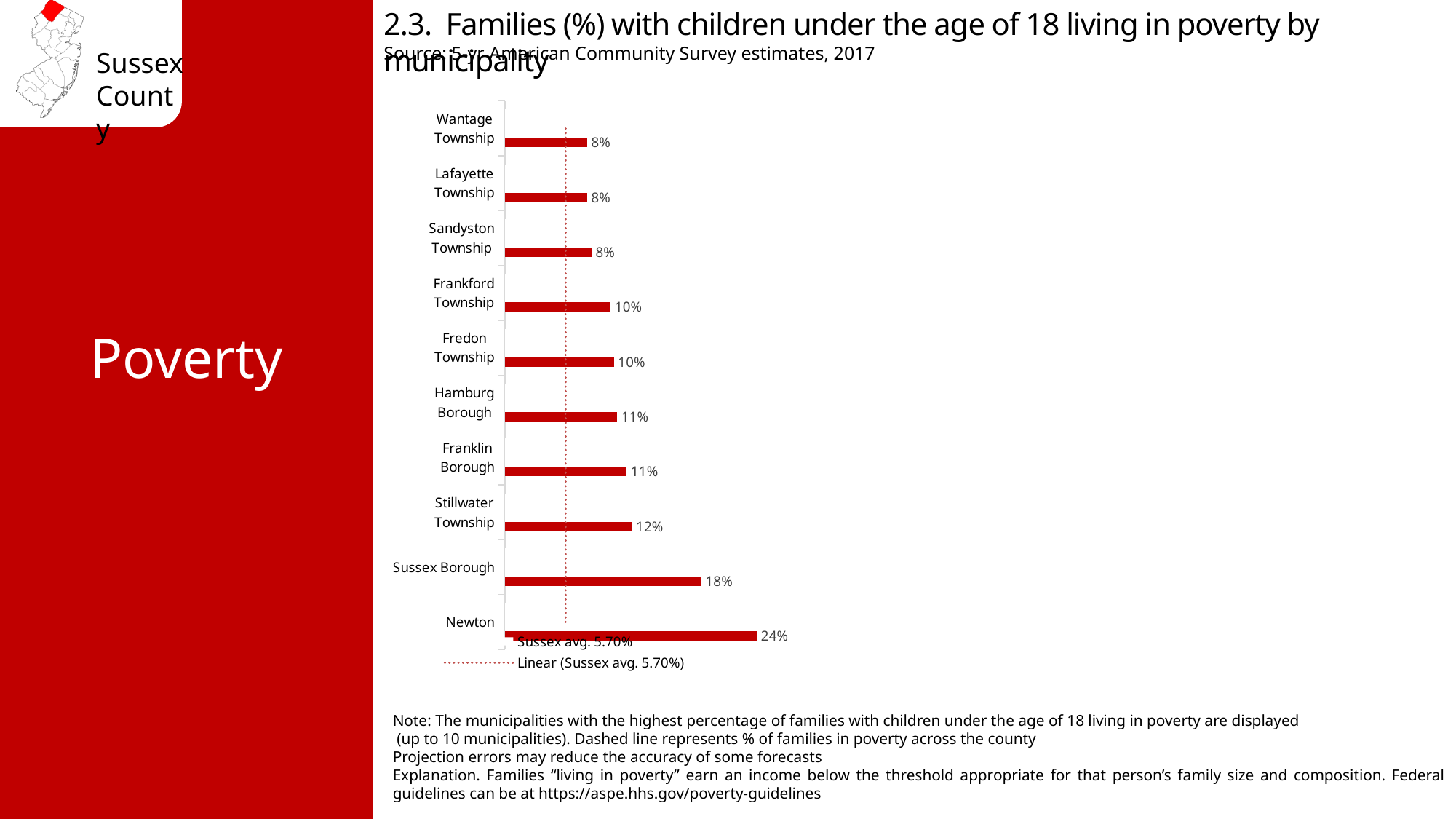
What is the value shown for Frankford Township? 10% What is the value shown for Stillwater Township? 12% What is the difference between the values for Sussex Borough and Stillwater Township? 6% Which has a higher value, Sussex Borough or Fredon Township? Sussex Borough What is the difference between the values for Newton and Sussex Borough? 6% What percentage of families with children under 18 are living in poverty in Newton? 24% What is the value shown for Sussex Borough? 18% What type of chart is used to display the data? Bar chart What county average value is shown by the dashed line in the chart legend? 5.70% Which municipality has the highest percentage of families with children under 18 living in poverty? Newton Which has a higher value, Hamburg Borough or Wantage Township? Hamburg Borough How many municipalities are shown in the chart? 10